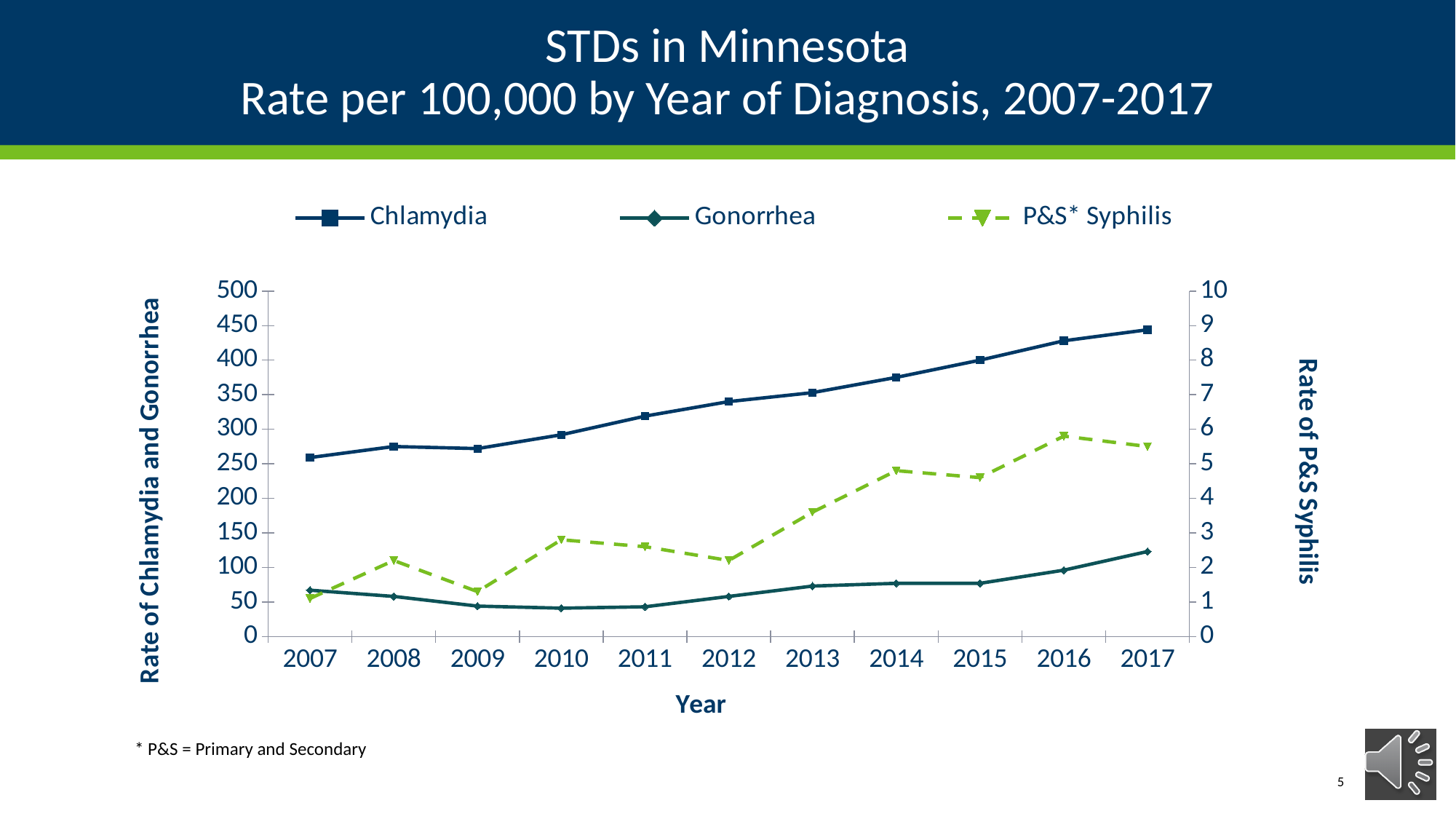
How many years are plotted along the x axis? 11 What kind of chart is shown on the slide? line chart In which year is the P&S Syphilis rate highest? 2016 Is the Chlamydia rate in 2007 greater or less than 300? less Is the P&S Syphilis rate in 2016 greater or less than 5 on the right axis? greater In which year is the Chlamydia rate highest? 2017 Does the Chlamydia rate rise or fall from 2007 to 2017? rises Which is larger, the P&S Syphilis rate in 2010 or in 2012? 2010 Is the Chlamydia rate in 2017 greater or less than 400? greater How many series does the legend list? 3 In which year is the Gonorrhea rate highest? 2017